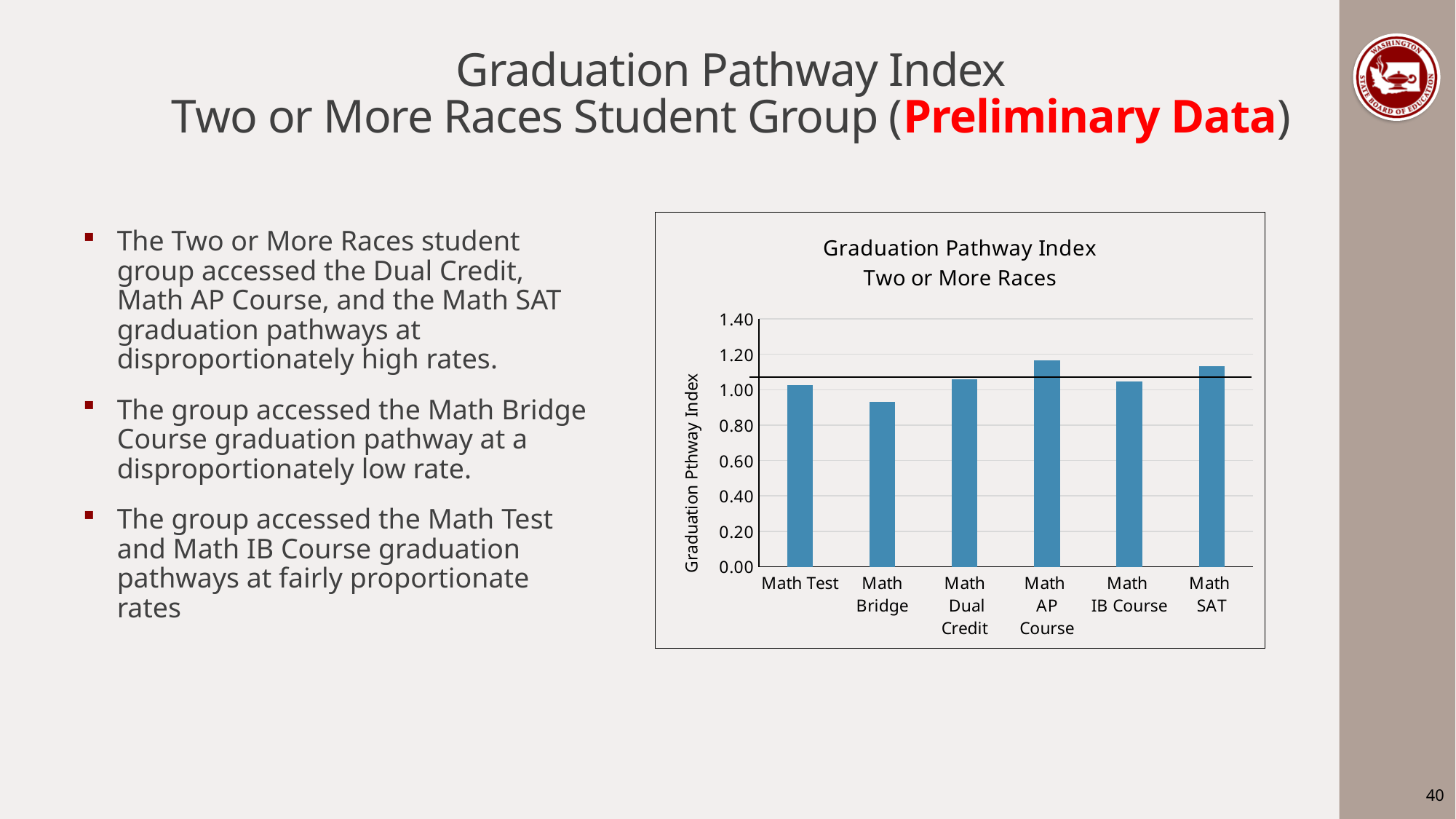
What is the title of the chart? Graduation Pathway Index Two or More Races Which graduation pathway has the lowest Graduation Pathway Index? Math Bridge Which graduation pathway has the highest Graduation Pathway Index? Math AP Course Is the value for Math Bridge greater or less than 0.80? greater What kind of chart is shown on the slide? Bar chart How many graduation pathways are plotted in the chart? 6 Which has a higher Graduation Pathway Index, Math AP Course or Math Bridge? Math AP Course Is the value for Math Bridge greater or less than 1.00? less Is the value for Math SAT greater or less than 1.00? greater Which has a higher Graduation Pathway Index, Math SAT or Math Test? Math SAT What is the label on the vertical axis of the chart? Graduation Pthway Index